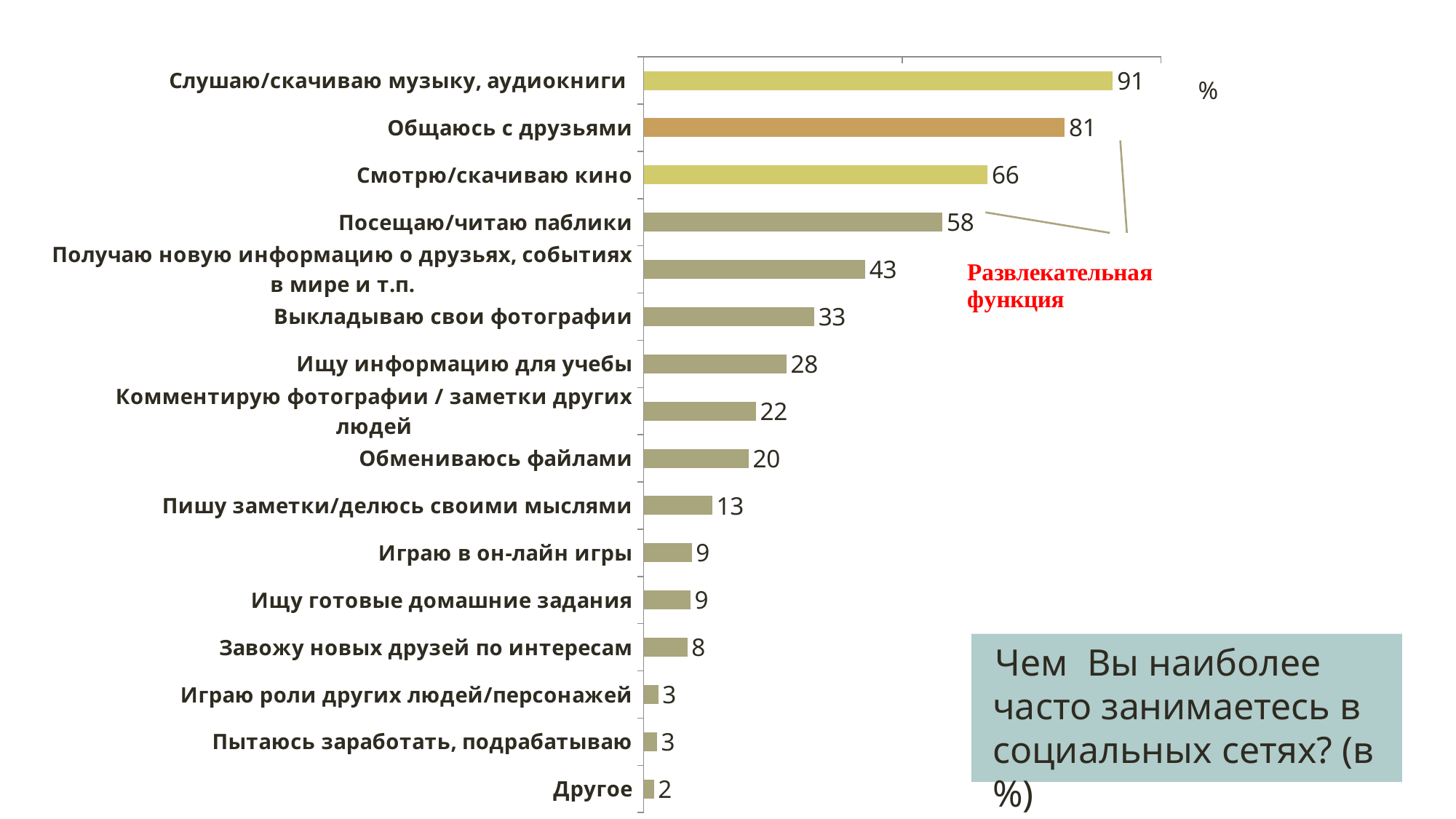
What value is shown for "Обмениваюсь файлами"? 20 What is the red annotation text next to the chart? Развлекательная функция What value is shown for "Общаюсь с друзьями"? 81 Which is larger: the value for "Ищу информацию для учебы" or the value for "Комментирую фотографии / заметки других людей"? Ищу информацию для учебы What is the difference between the values for "Слушаю/скачиваю музыку, аудиокниги" and "Общаюсь с друзьями"? 10 What kind of chart is shown on the slide? bar chart Which category has the highest value? Слушаю/скачиваю музыку, аудиокниги Which category has the lowest value? Другое How many categories are shown in the chart? 16 What value is shown for "Выкладываю свои фотографии"? 33 What is the difference between the values for "Смотрю/скачиваю кино" and "Посещаю/читаю паблики"? 8 What value is shown for "Слушаю/скачиваю музыку, аудиокниги"? 91